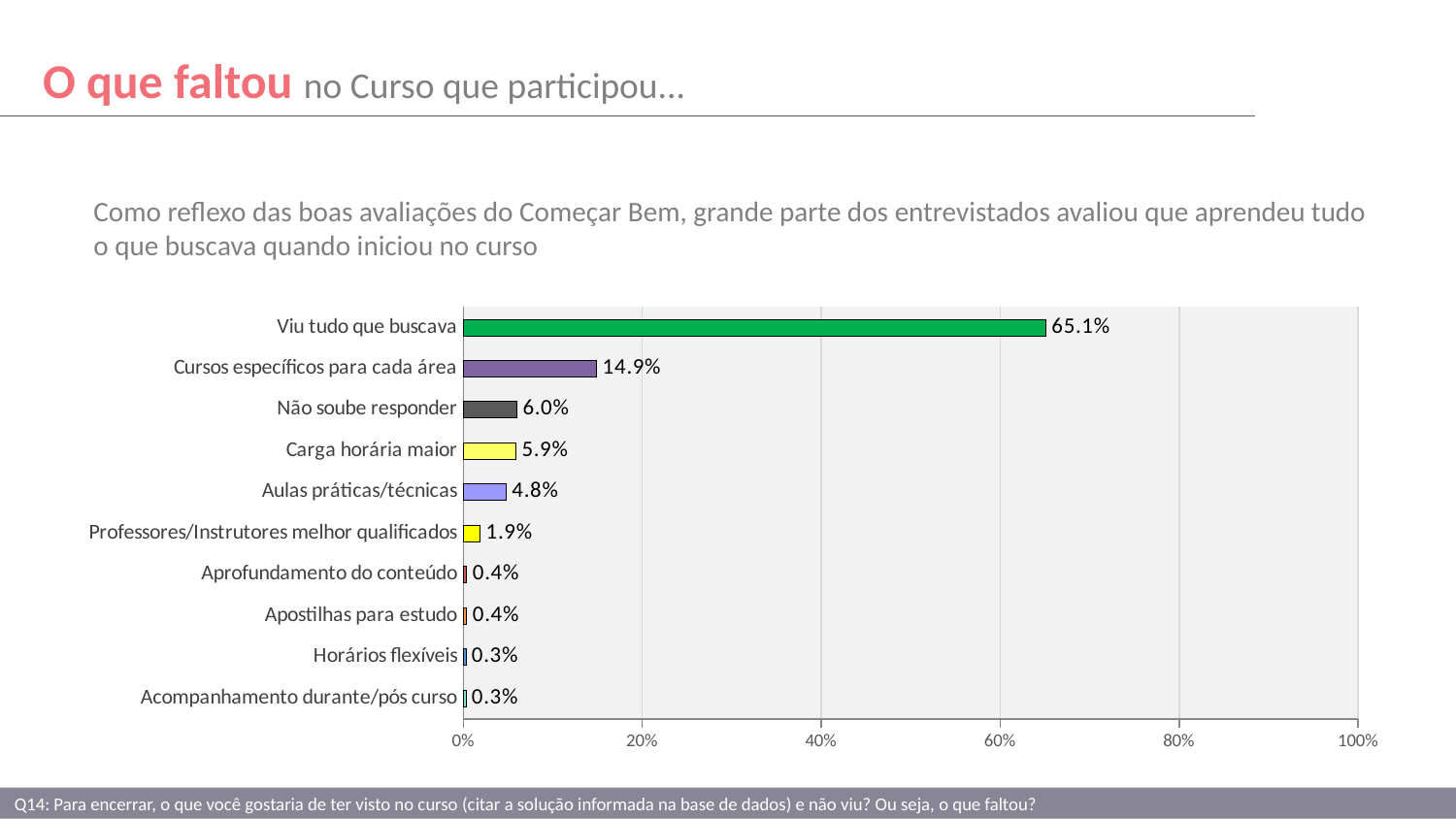
What is the value for "Horários flexíveis"? 0.3% What is the difference between "Não soube responder" and "Carga horária maior"? 0.1% What is the value for "Viu tudo que buscava"? 65.1% What is the value for "Cursos específicos para cada área"? 14.9% What is the value for "Aulas práticas/técnicas"? 4.8% Which is larger, "Cursos específicos para cada área" or "Não soube responder"? Cursos específicos para cada área Is the value for "Viu tudo que buscava" greater or less than 60%? greater What is the difference between "Viu tudo que buscava" and "Cursos específicos para cada área"? 50.2% What is the value for "Professores/Instrutores melhor qualificados"? 1.9% How many categories are shown in the chart? 10 What kind of chart is shown on the slide? Bar chart Which category has the highest value? Viu tudo que buscava